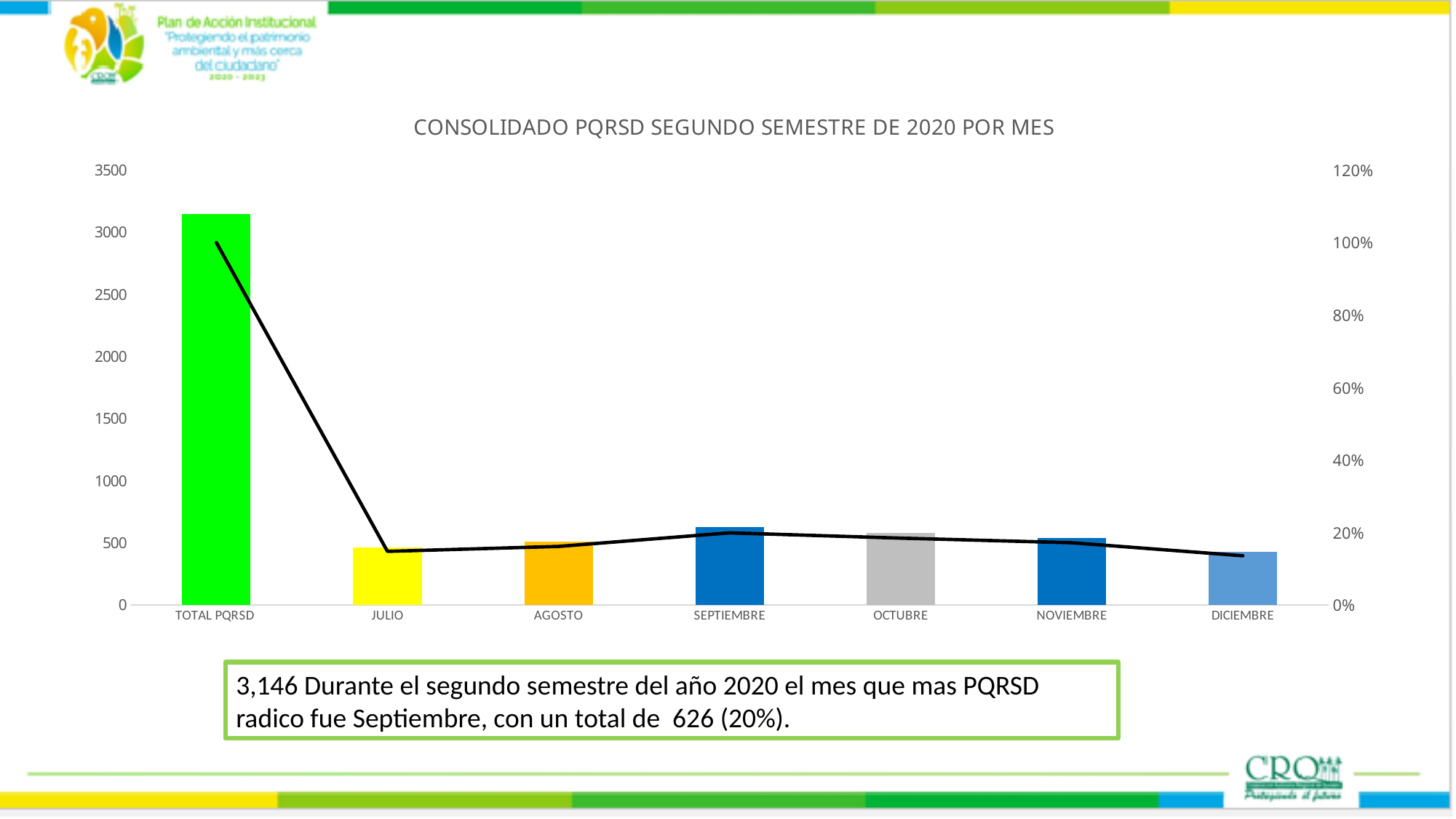
What colour is the TOTAL PQRSD bar? Green Which is larger, the bar for SEPTIEMBRE or the bar for DICIEMBRE? SEPTIEMBRE Which month has the shortest bar in the chart? DICIEMBRE Which month has the tallest bar in the chart? SEPTIEMBRE Is the value for TOTAL PQRSD greater or less than 3000? greater According to the slide, how many PQRSD were filed in Septiembre? 626 According to the slide, what is the total PQRSD for the second semester of 2020? 3,146 Is the value for OCTUBRE greater or less than 500? greater How many categories are shown on the x axis of the chart? 7 Is the value for DICIEMBRE greater or less than 500? less What is the title of the chart? CONSOLIDADO PQRSD SEGUNDO SEMESTRE DE 2020 POR MES